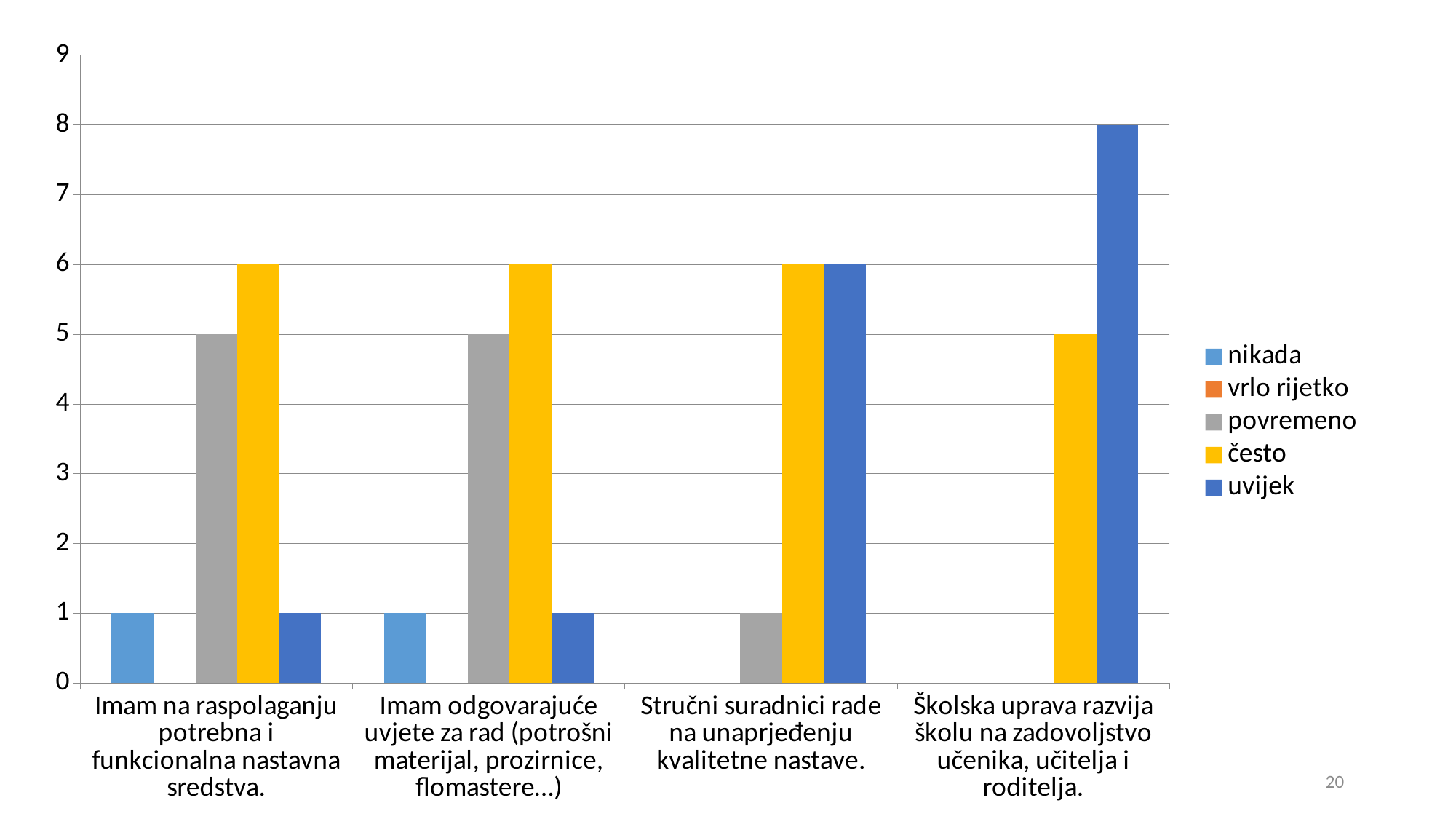
How many categories are shown on the x axis? 4 What is the value of 'nikada' for 'Imam na raspolaganju potrebna i funkcionalna nastavna sredstva.'? 1 What kind of chart is shown on the slide? bar chart What is the value of 'povremeno' for 'Imam odgovarajuće uvjete za rad (potrošni materijal, prozirnice, flomastere…)'? 5 Which category has the highest 'uvijek' value? Školska uprava razvija školu na zadovoljstvo učenika, učitelja i roditelja. How many series does the legend list? 5 What is the difference between the 'uvijek' value and the 'često' value for 'Školska uprava razvija školu na zadovoljstvo učenika, učitelja i roditelja.'? 3 What is the value of 'uvijek' for 'Školska uprava razvija školu na zadovoljstvo učenika, učitelja i roditelja.'? 8 Is the 'uvijek' value for 'Školska uprava razvija školu na zadovoljstvo učenika, učitelja i roditelja.' greater or less than 7? greater Which legend entry is shown in yellow? često For 'Stručni suradnici rade na unaprjeđenju kvalitetne nastave.', which is larger: 'povremeno' or 'često'? često What is the value of 'često' for 'Imam na raspolaganju potrebna i funkcionalna nastavna sredstva.'? 6